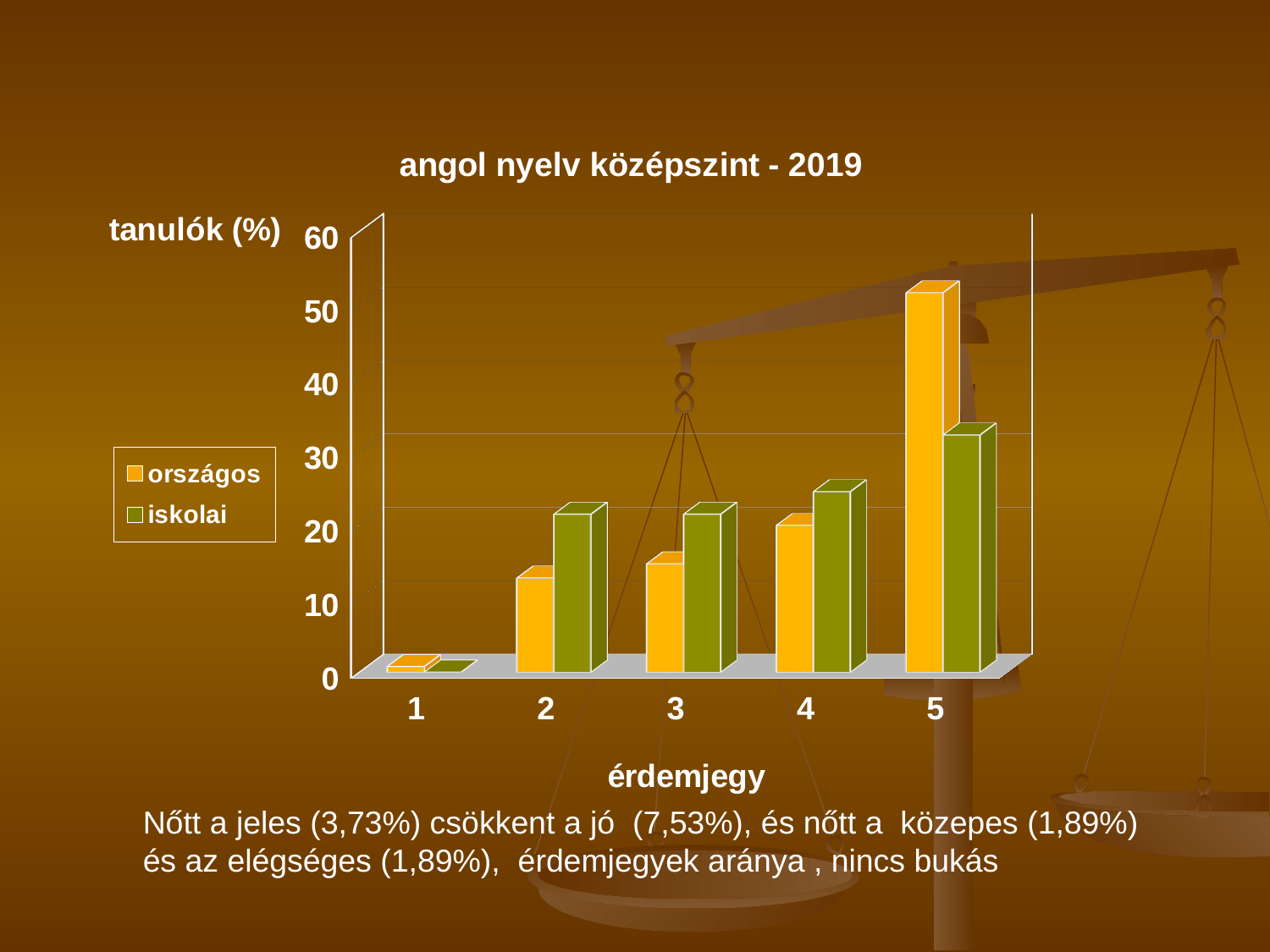
For grade 2, which series has the larger value, országos or iskolai? iskolai For which grade is the országos value lowest? 1 How many grade categories (érdemjegy) are shown on the x axis? 5 Is the országos value for grade 2 greater or less than 20? less For which grade is the országos value highest? 5 What is the title of the chart? angol nyelv középszint - 2019 For which grade is the iskolai value highest? 5 Is the országos value for grade 5 greater or less than 40? greater For grade 5, which series has the larger value, országos or iskolai? országos How many series does the legend list? 2 What kind of chart is shown on the slide? bar chart